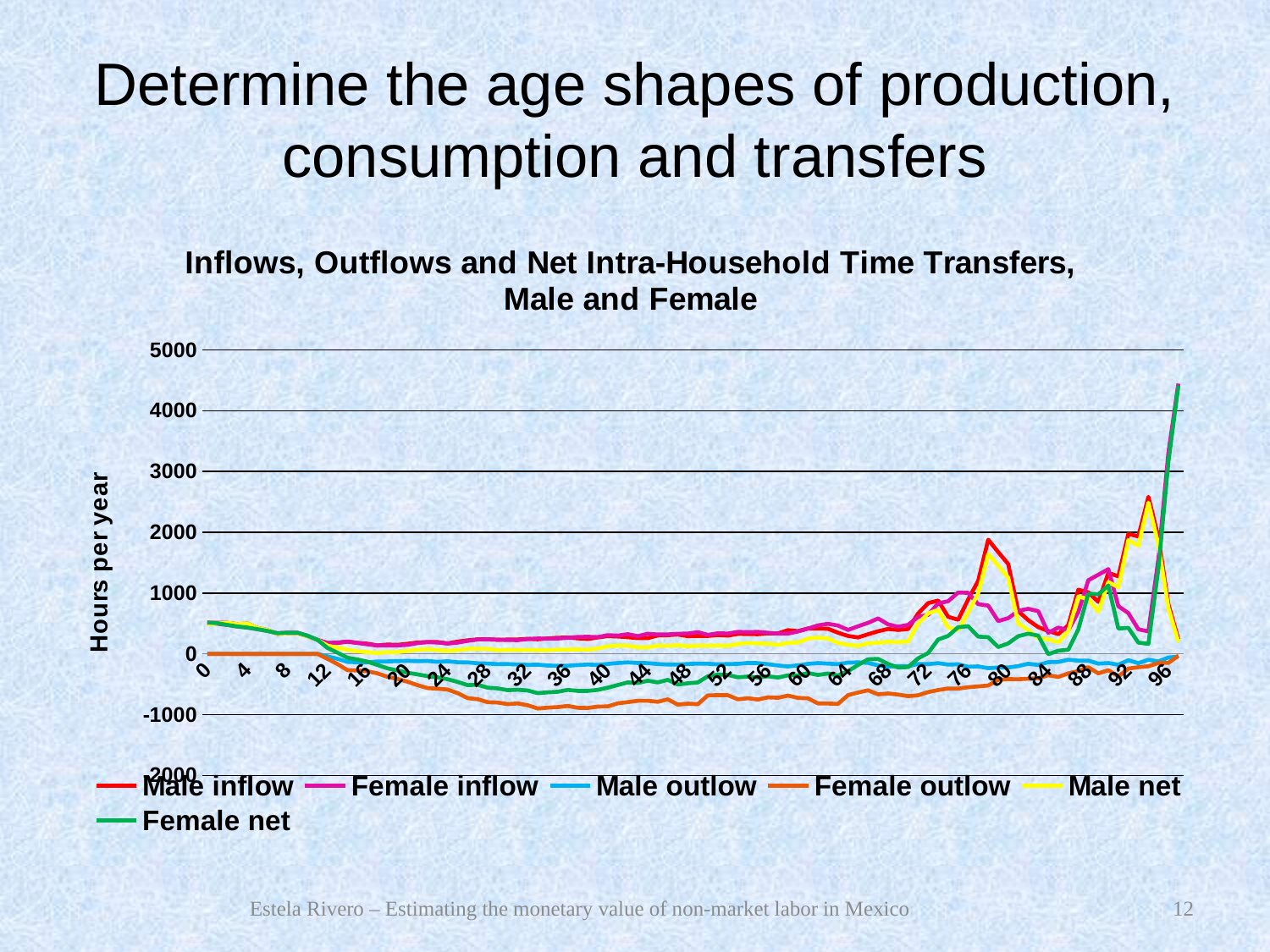
How many series does the legend list? 6 At age 80, which is larger: Male inflow or Female inflow? Male inflow Which series reaches the lowest value on the chart? Female outflow What is the title of the chart? Inflows, Outflows and Net Intra-Household Time Transfers, Male and Female Is the value for Male inflow at age 80 greater or less than 1000? greater What is the label on the vertical axis of the chart? Hours per year Does the Female outflow series rise or fall from age 0 to age 32? fall Is the value for Female outflow at age 32 greater or less than 0? less What kind of chart is shown on the slide? line chart Is the value for Female inflow at age 0 greater or less than 1000? less